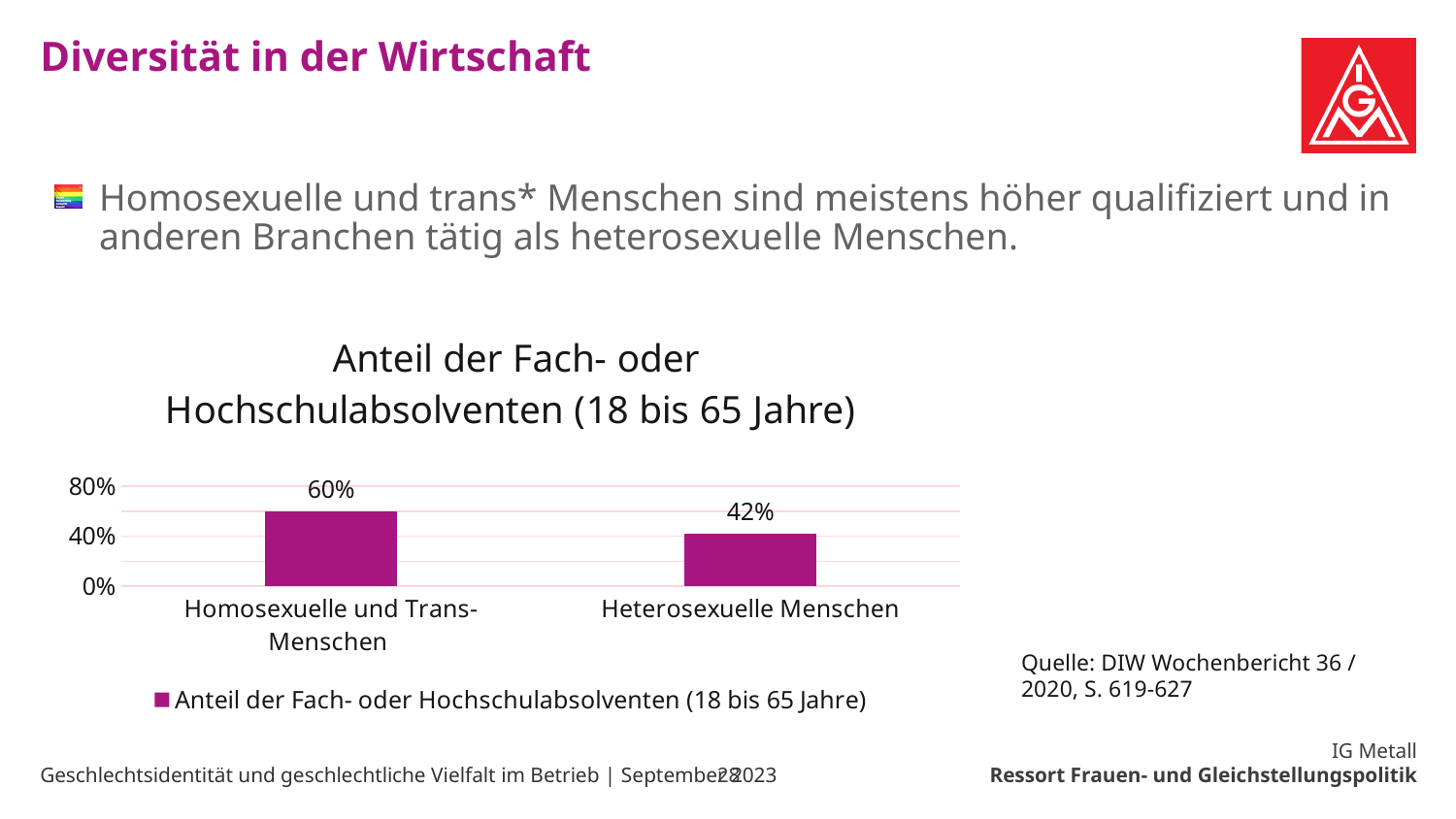
What kind of chart is shown on the slide? bar chart Is the value for Homosexuelle und Trans-Menschen greater or less than 80%? less What is the value for Homosexuelle und Trans-Menschen? 60% What is the value for Heterosexuelle Menschen? 42% Which category has the lowest value? Heterosexuelle Menschen Is the value for Heterosexuelle Menschen greater or less than 40%? greater What is the difference between the values for Homosexuelle und Trans-Menschen and Heterosexuelle Menschen? 18% Which is larger, the value for Homosexuelle und Trans-Menschen or for Heterosexuelle Menschen? Homosexuelle und Trans-Menschen What is the title of the chart? Anteil der Fach- oder Hochschulabsolventen (18 bis 65 Jahre) How many series does the legend list? 1 How many categories are shown in the chart? 2 Which category has the highest value? Homosexuelle und Trans-Menschen